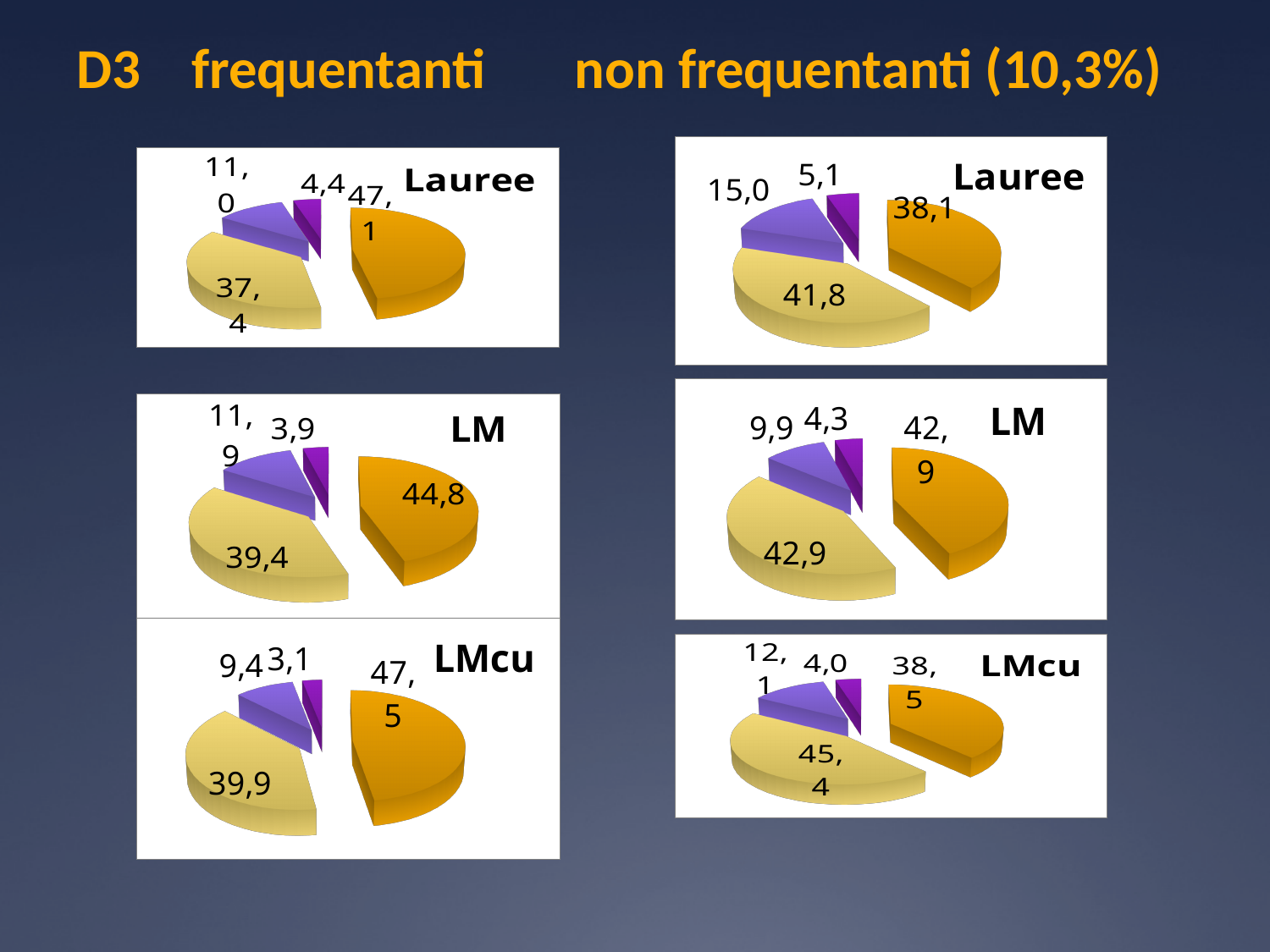
What type of charts are shown on the slide? pie charts In the 'LMcu' pie chart under 'frequentanti' (bottom left), what is the value of the largest slice? 47,5 How many pie charts are on the slide? 6 How many slices does each pie chart on the slide have? 4 In the 'Lauree' pie chart under 'non frequentanti' (top right), what is the value of the yellow slice? 41,8 What percentage is shown in the slide title next to 'non frequentanti'? 10,3% In the 'LM' pie chart under 'frequentanti' (middle left), what is the value of the smallest slice? 3,9 In the 'LMcu' pie chart under 'non frequentanti' (bottom right), what is the value of the purple slice? 12,1 In the 'Lauree' pie chart under 'non frequentanti' (top right), what is the difference between the yellow slice (41,8) and the orange slice (38,1)? 3,7 In the 'LM' pie chart under 'non frequentanti' (middle right), what is the value of the magenta slice? 4,3 In the 'Lauree' pie chart under 'frequentanti' (top left), what is the value of the orange slice? 47,1 Which is larger in the 'LMcu' pie chart under 'non frequentanti' (bottom right): the yellow slice or the orange slice? the yellow slice (45,4)